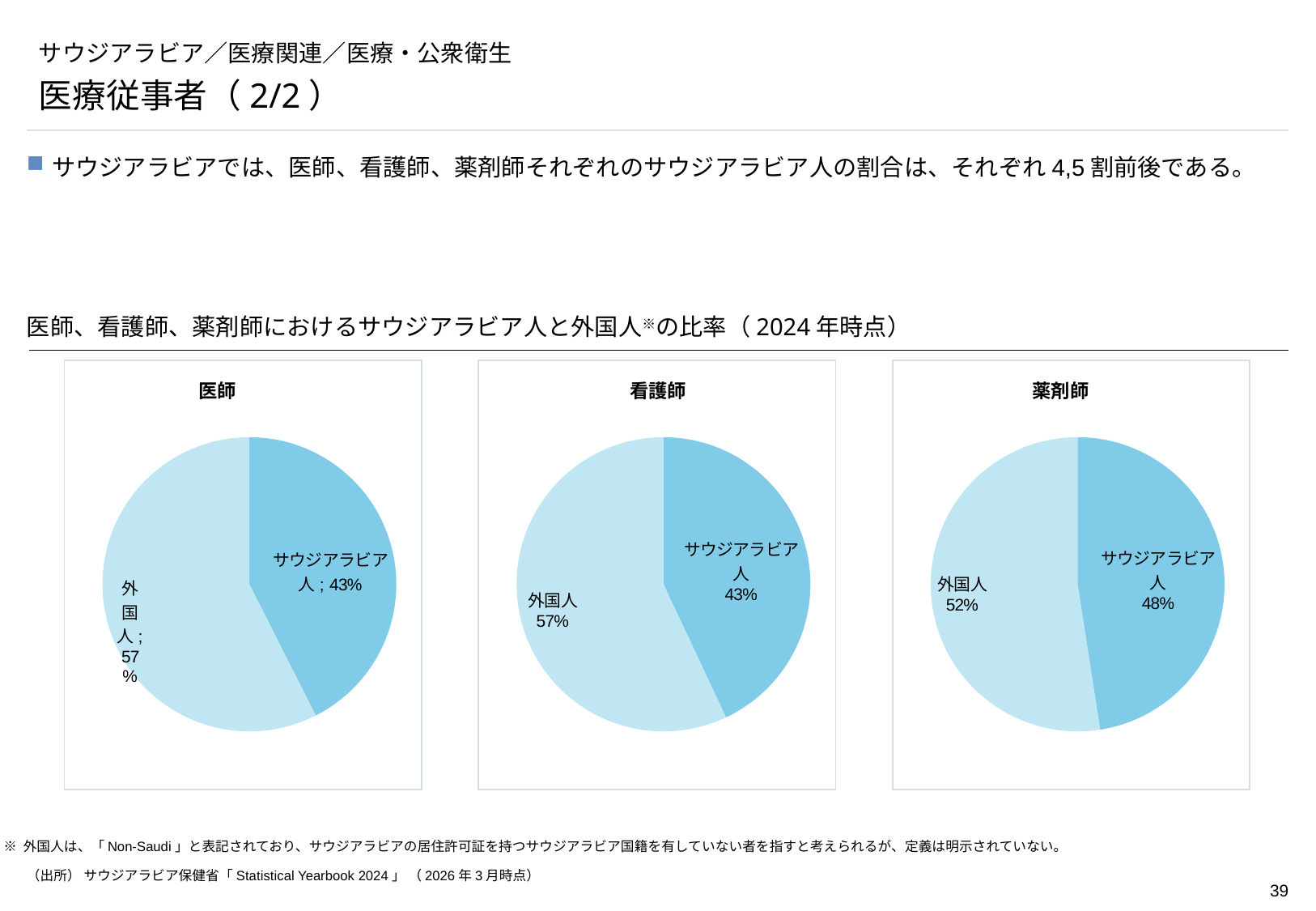
In the 医師 pie chart, what share is labelled for サウジアラビア人? 43% In the 薬剤師 pie chart, what share is labelled for 外国人? 52% In the 薬剤師 pie chart, what is the difference in percentage points between 外国人 and サウジアラビア人? 4 How many slices does the 看護師 pie chart have? 2 In the 看護師 pie chart, what share is labelled for 外国人? 57% In the 薬剤師 pie chart, which slice is larger, サウジアラビア人 or 外国人? 外国人 What type of chart is used for 医師, 看護師 and 薬剤師 on this slide? Pie chart In the 看護師 pie chart, which slice is the largest? 外国人 In the 薬剤師 pie chart, what share is labelled for サウジアラビア人? 48% In the 医師 pie chart, what share is labelled for 外国人? 57% How many pie charts are shown on the slide? 3 In the 医師 pie chart, what is the difference in percentage points between 外国人 and サウジアラビア人? 14